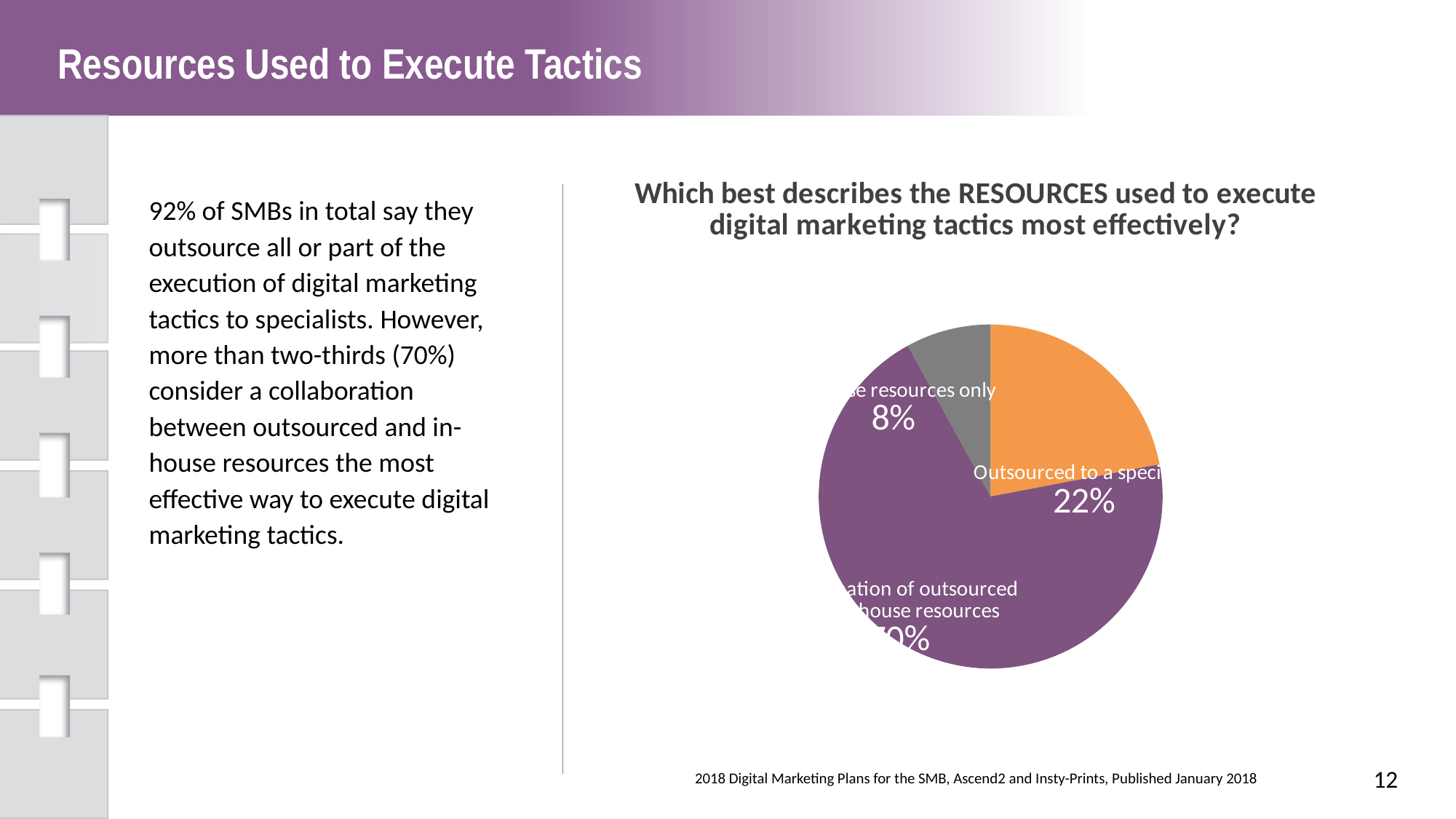
Which is larger: the 'Outsourced to a specialist' slice or the 'In-house resources only' slice? Outsourced to a specialist What colour is the 'Outsourced to a specialist' slice? orange Which slice of the pie chart is the smallest? In-house resources only What is the combined share of the 'Outsourced to a specialist' and 'In-house resources only' slices? 30% What percentage of the pie is the 'Outsourced to a specialist' slice? 22% How many slices does the pie chart have? 3 What kind of chart is shown on the slide? pie chart What percentage of the pie is the 'In-house resources only' slice? 8% What is the difference in percentage points between the 'Outsourced to a specialist' slice and the 'In-house resources only' slice? 14 What percentage of the pie is the 'Combination of outsourced and in-house resources' slice? 70% Which slice of the pie chart is the largest? Combination of outsourced and in-house resources What is the title of the pie chart? Which best describes the RESOURCES used to execute digital marketing tactics most effectively?